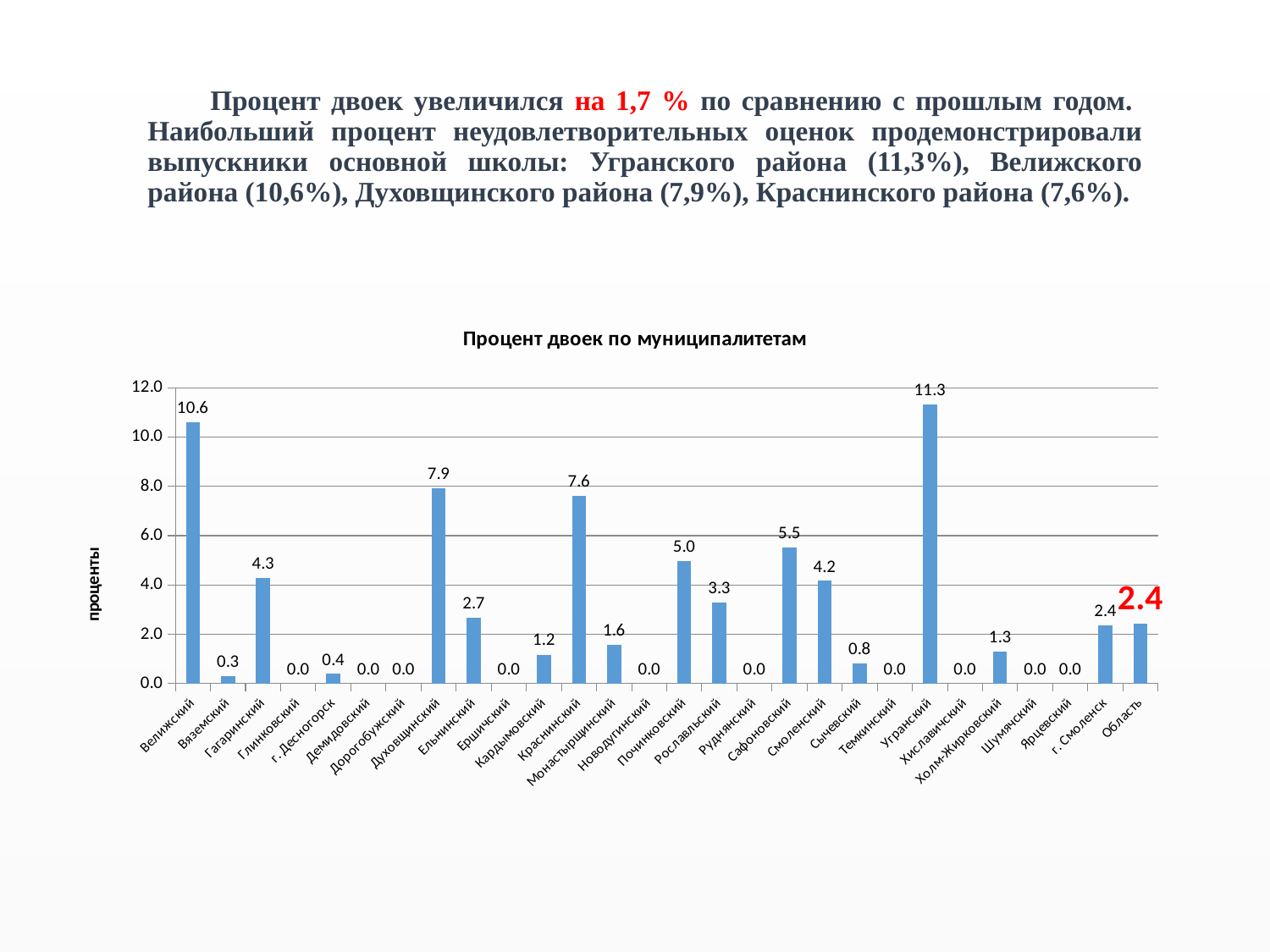
Which municipality has the highest percentage of failing grades? Угранский What is the value for Область? 2.4 What is the title of the chart? Процент двоек по муниципалитетам What is the value for Угранский? 11.3 What is the value for Велижский? 10.6 Is the value for Починковский greater or less than 4.0? greater Which is larger, the value for Гагаринский or the value for Смоленский? Гагаринский What kind of chart is shown on the slide? bar chart What is the value for Сафоновский? 5.5 What is the difference between the values for Духовщинский and Краснинский? 0.3 What is the difference between the values for Угранский and Велижский? 0.7 How many municipalities (categories) are shown on the x axis? 28